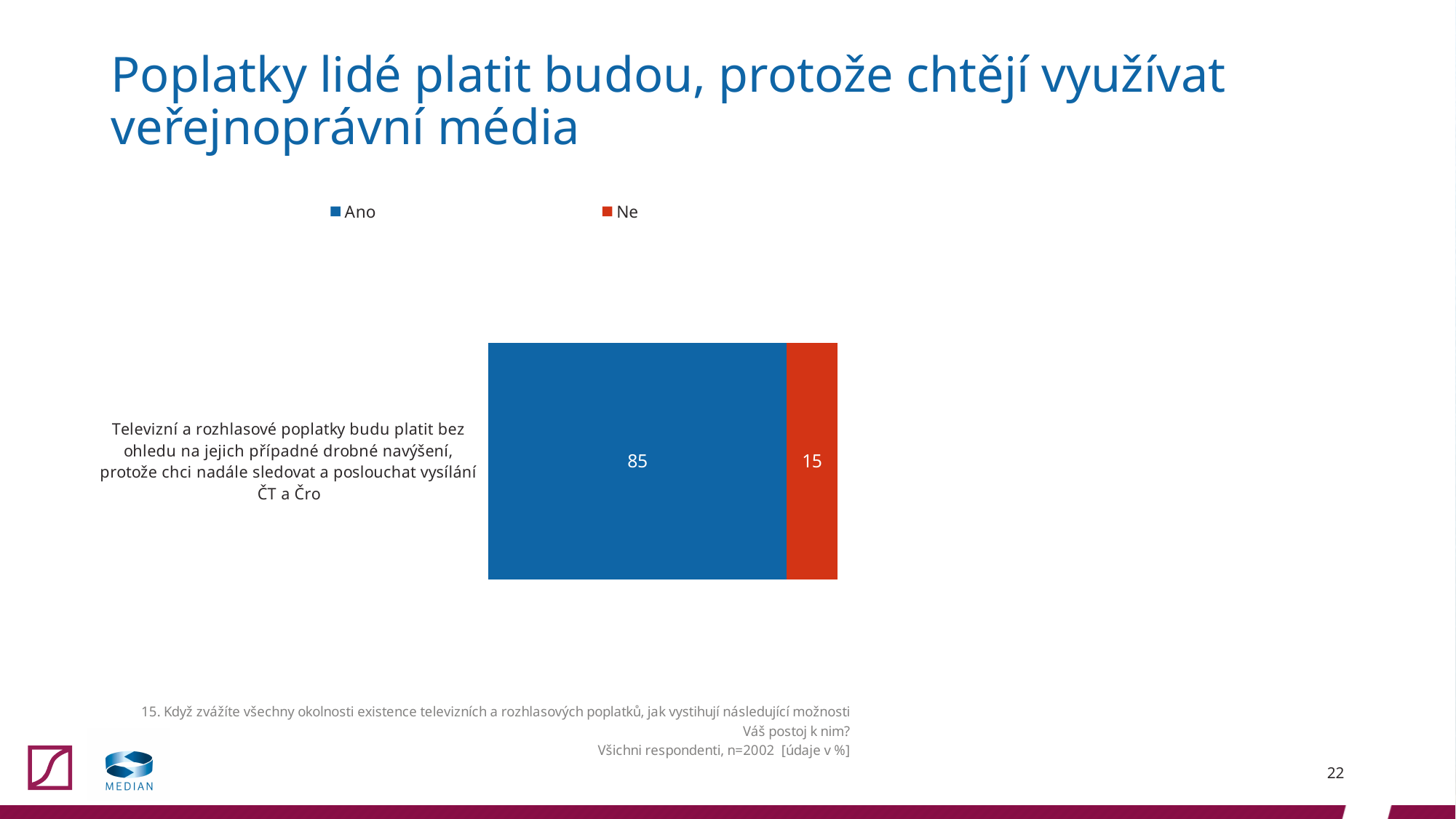
What is the value for "Ano" in the chart? 85 What is the difference between the "Ano" and "Ne" values? 70 How many series does the legend list? 2 Which series has the largest value in the chart? Ano Which series has the smallest value in the chart? Ne Which series is shown in red? Ne What is the total of the stacked bar? 100 How many categories (bars) are plotted in the chart? 1 What is the value for "Ne" in the chart? 15 Which series is shown in blue? Ano What kind of chart is shown on the slide? Stacked bar chart Which series has the larger value, "Ano" or "Ne"? Ano